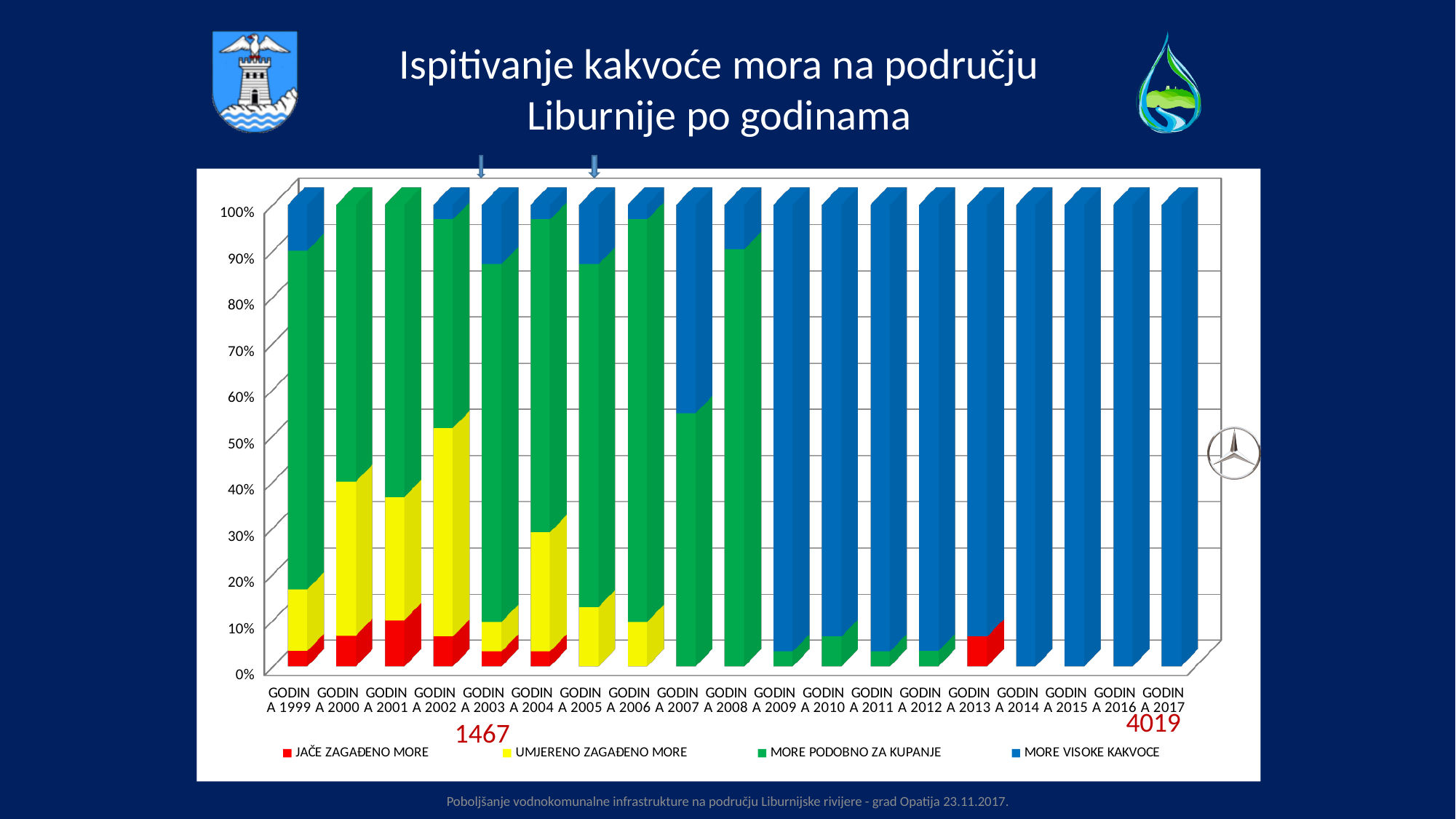
Is the MORE PODOBNO ZA KUPANJE (green) segment larger for GODINA 2007 or GODINA 2008? GODINA 2008 Which year has the largest UMJERENO ZAGAĐENO MORE (yellow) segment? GODINA 2002 Is the MORE VISOKE KAKVOCE (blue) share for GODINA 2009 greater or less than 90%? greater What is the title of the chart on the slide? Ispitivanje kakvoće mora na području Liburnije po godinama Does the share of MORE VISOKE KAKVOCE (blue) generally rise or fall from 1999 to 2017? Rise What kind of chart is shown on the slide? Stacked bar chart Is the MORE VISOKE KAKVOCE (blue) share for GODINA 2008 greater or less than 20%? less Which is the first year in which the bar is entirely MORE VISOKE KAKVOCE (blue)? GODINA 2014 Which colour represents the series MORE VISOKE KAKVOCE in the chart? Blue How many series does the chart legend list? 4 How many years (categories) are shown on the x axis of the chart? 19